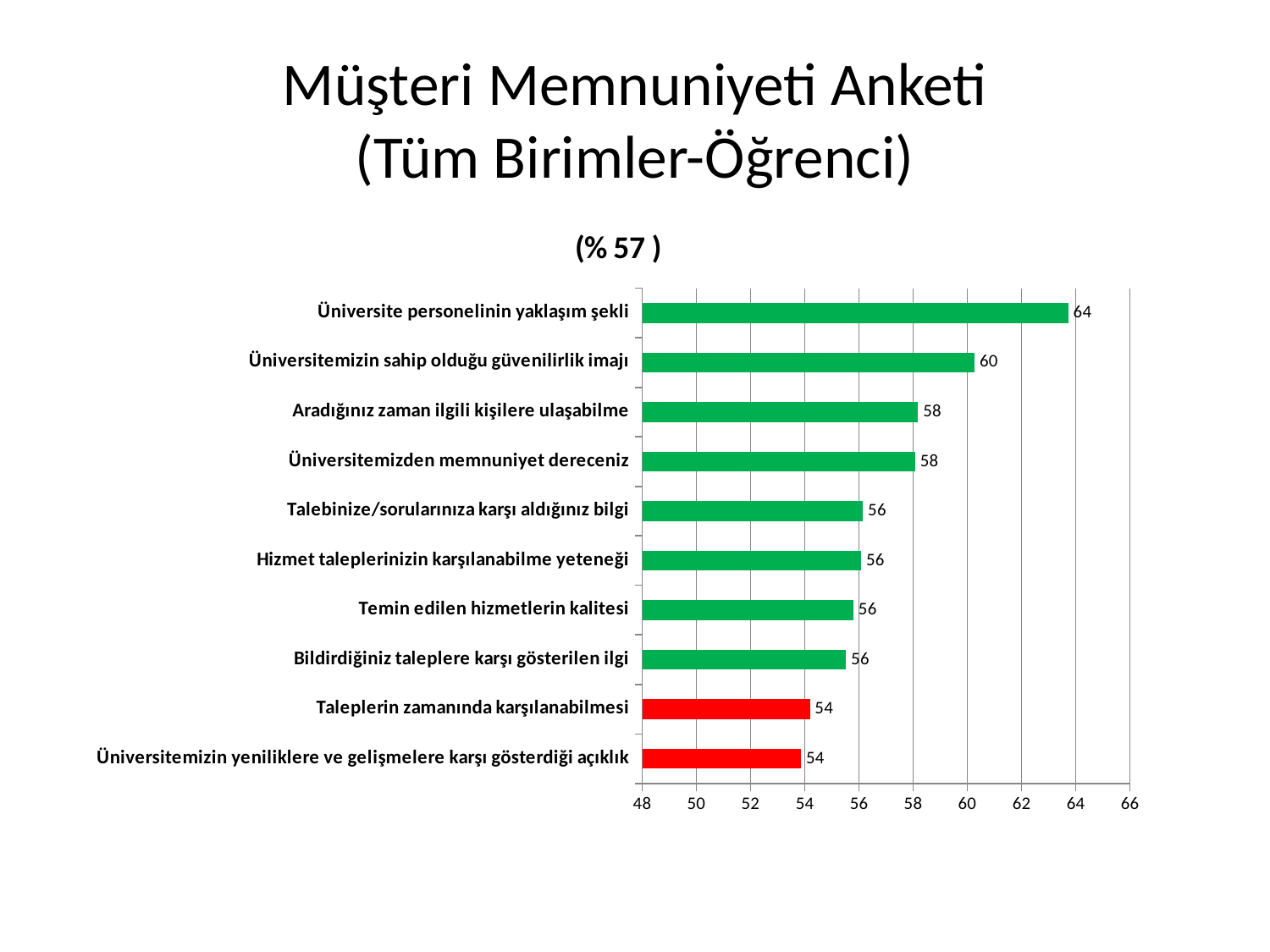
What is the value for "Üniversite personelinin yaklaşım şekli"? 64 What is the value for "Taleplerin zamanında karşılanabilmesi"? 54 What is the value for "Temin edilen hizmetlerin kalitesi"? 56 What kind of chart is shown on the slide? bar chart How many bars are coloured red? 2 What is the title of the chart? (% 57 ) Is the value for "Üniversitemizin sahip olduğu güvenilirlik imajı" greater or less than 58? greater How many categories are shown in the chart? 10 Which is larger: the value for "Aradığınız zaman ilgili kişilere ulaşabilme" or the value for "Üniversitemizin yeniliklere ve gelişmelere karşı gösterdiği açıklık"? Aradığınız zaman ilgili kişilere ulaşabilme Which category has the highest value? Üniversite personelinin yaklaşım şekli What is the value for "Üniversitemizin sahip olduğu güvenilirlik imajı"? 60 What is the difference between the values for "Üniversite personelinin yaklaşım şekli" and "Üniversitemizin sahip olduğu güvenilirlik imajı"? 4